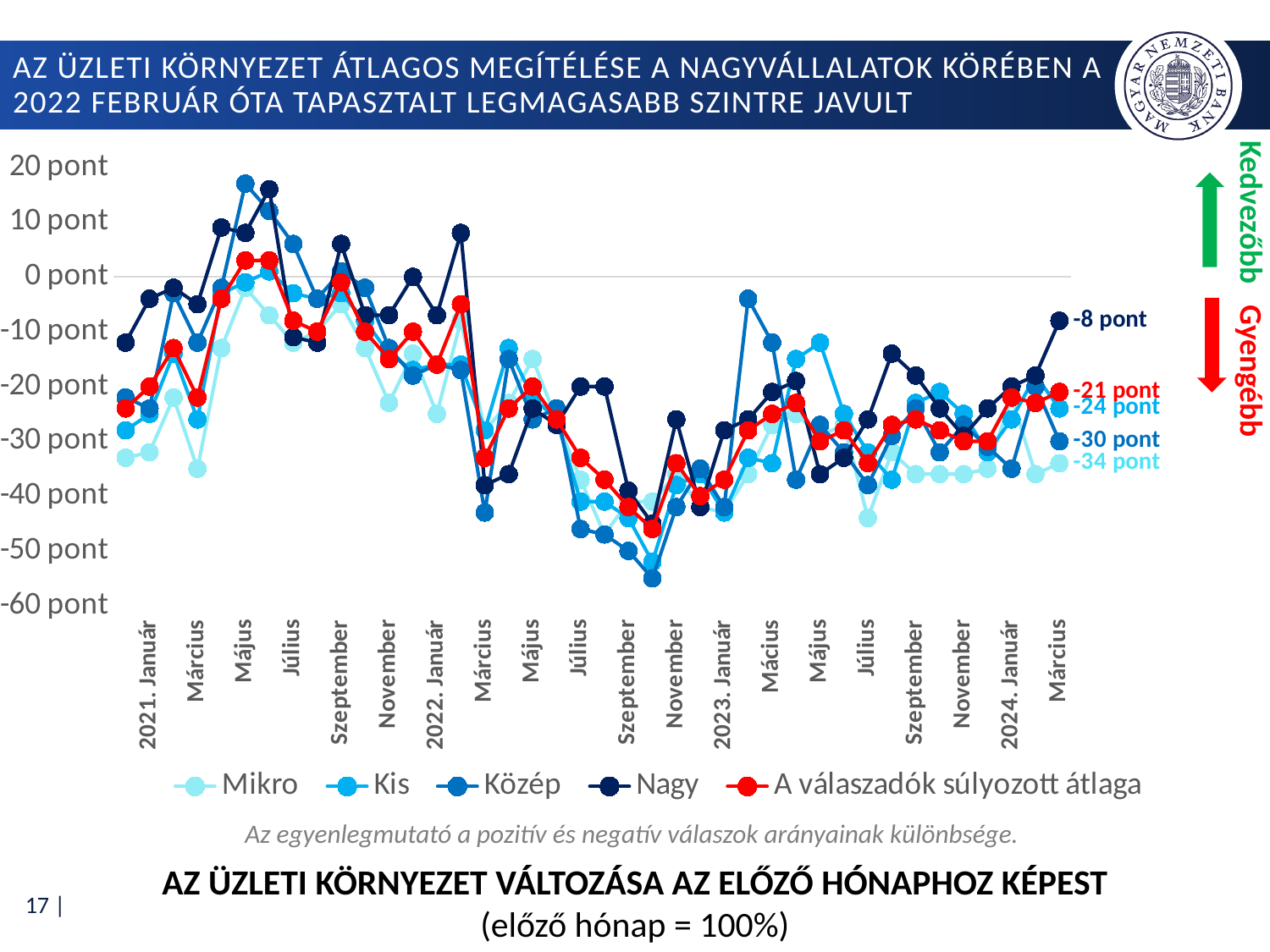
What is the latest value shown for 'A válaszadók súlyozott átlaga' at the right end of the chart? -21 pont Is the value of 'A válaszadók súlyozott átlaga' in 2021 March greater or less than -10 pont? less What is the difference between the end values of the Nagy series (-8 pont) and the Mikro series (-34 pont)? 26 pont Which series has the lowest value at the right end of the chart (2024 March)? Mikro At the right end of the chart, which is higher: the Kis series or the Közép series? Kis What colour is the line for 'A válaszadók súlyozott átlaga'? red What is the latest value shown for the Közép series at the right end of the chart? -30 pont How many series does the legend list? 5 What is the latest value shown for the Nagy series at the right end of the chart? -8 pont What kind of chart is shown on the slide? line chart What is the latest value shown for the Mikro series at the right end of the chart? -34 pont Which series has the highest value at the right end of the chart (2024 March)? Nagy